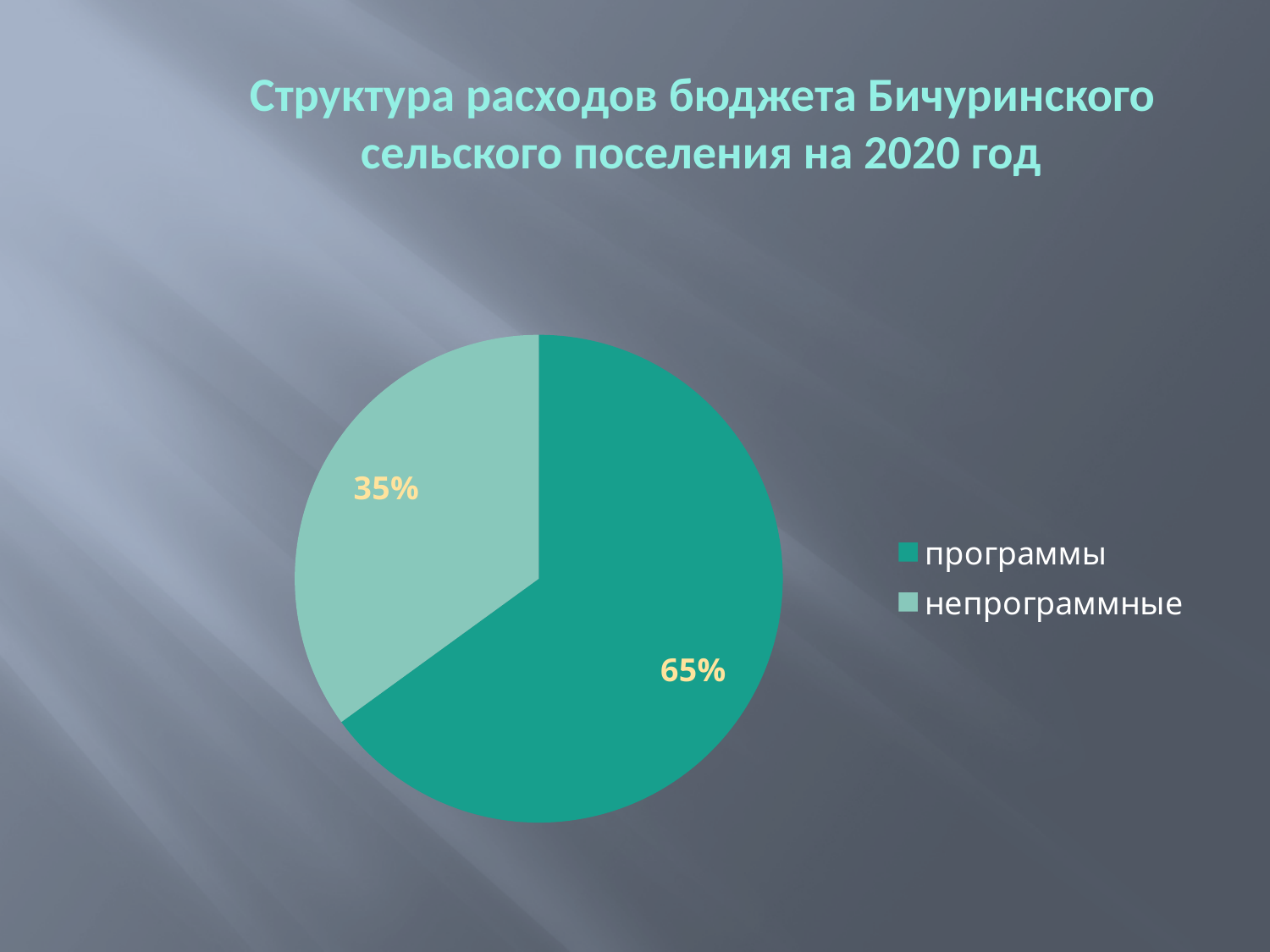
How many entries does the legend list? 2 What is the difference in percentage points between the "программы" and "непрограммные" slices? 30% What is the title of the chart on the slide? Структура расходов бюджета Бичуринского сельского поселения на 2020 год Which category has the largest slice of the pie? программы What share of the pie does the "непрограммные" slice represent? 35% Which is larger, the "программы" slice or the "непрограммные" slice? программы What type of chart is shown on the slide? pie chart How many slices does the pie chart have? 2 Which legend entry is shown in the lighter green colour? непрограммные What share of the pie does the "программы" slice represent? 65% Which category has the smallest slice of the pie? непрограммные